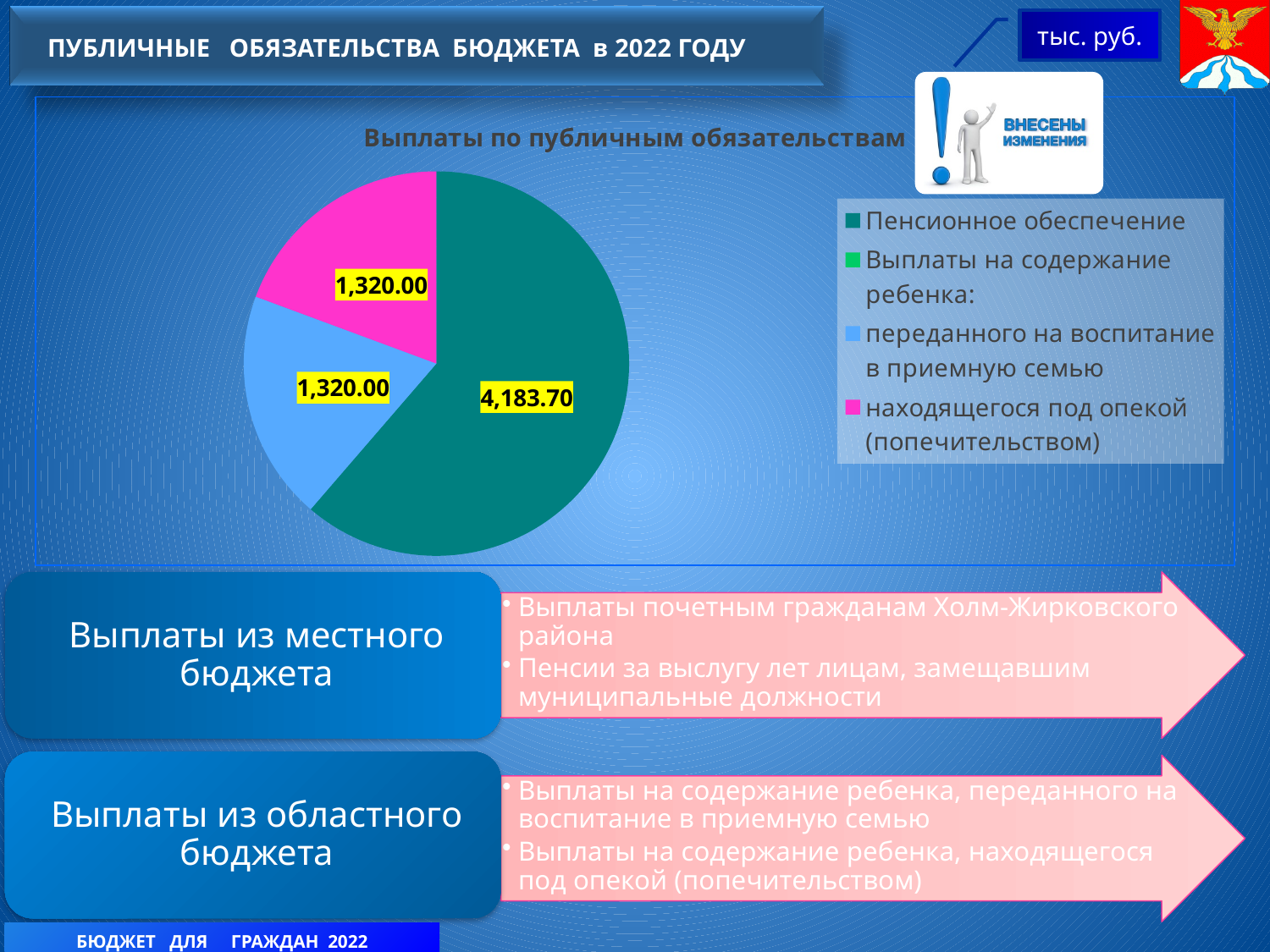
How many slices are shown in the pie chart? 3 Which is larger: the value for Пенсионное обеспечение or the value for 'переданного на воспитание в приемную семью'? Пенсионное обеспечение Which category has the largest slice of the pie? Пенсионное обеспечение What is the total of all the slices shown in the pie chart? 6,823.70 What is the value for Пенсионное обеспечение? 4,183.70 What type of chart is shown on the slide? pie chart What is the title of the chart? Выплаты по публичным обязательствам What colour is the slice for Пенсионное обеспечение? dark teal What is the difference between the value for Пенсионное обеспечение and the value for 'находящегося под опекой (попечительством)'? 2,863.70 What is the value for the slice 'находящегося под опекой (попечительством)'? 1,320.00 What is the value for the slice 'переданного на воспитание в приемную семью'? 1,320.00 How many entries does the legend list? 4